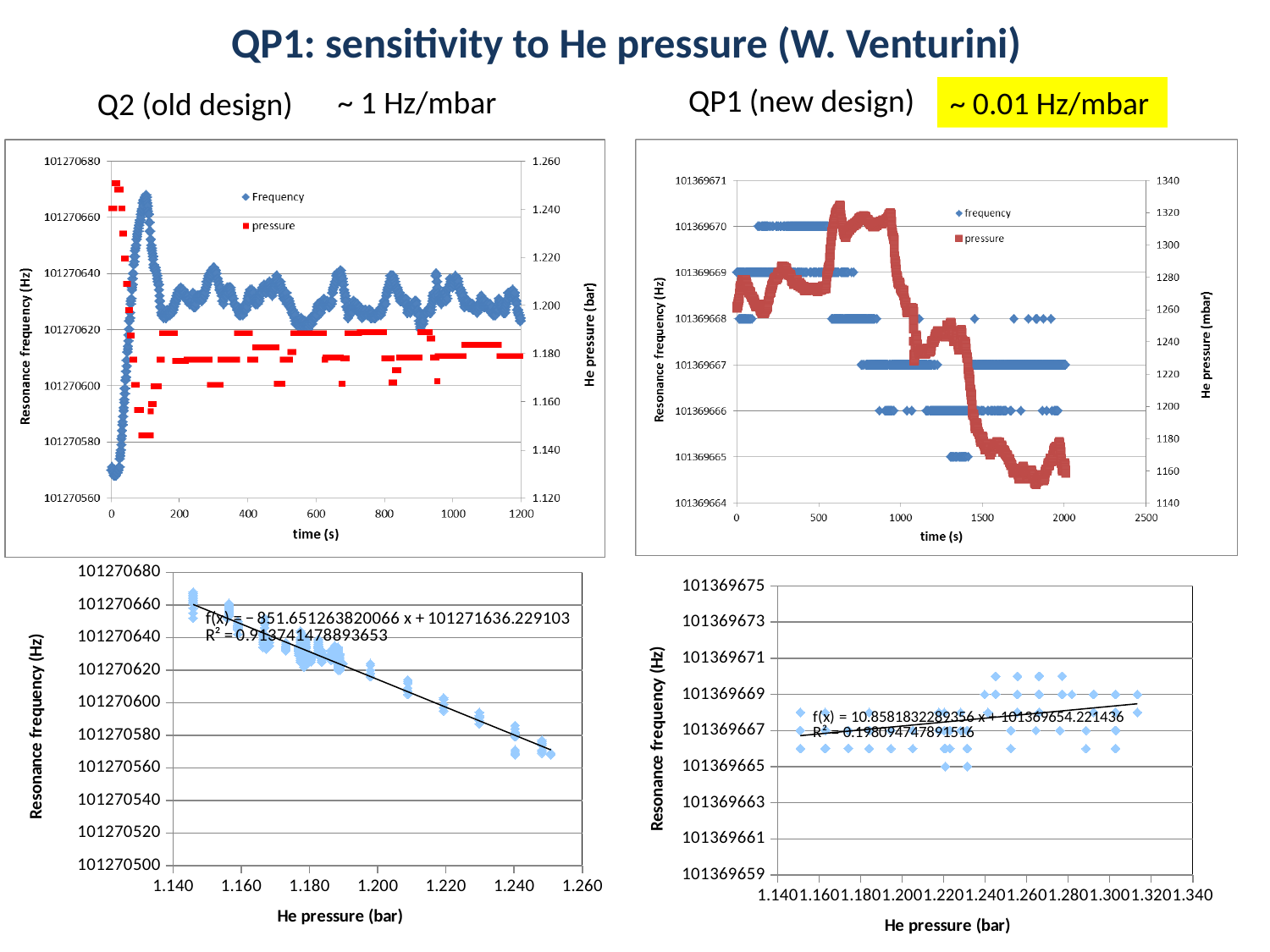
What kind of chart is the bottom-left chart (Resonance frequency vs He pressure for Q2)? scatter plot How many series does the legend of the top-left chart (Q2 old design, time series) list? 2 In the bottom-left chart, what is the slope of the fitted line f(x)? −851.651263820066 In the bottom-left chart, is the resonance frequency at a He pressure of 1.240 bar greater or less than 101270600? less In the top-right chart, is the He pressure at around 600 s greater or less than 1300 mbar? greater In the bottom-left chart, what is the R² value printed for the fitted line? 0.913741478893653 In the bottom-right chart, what is the slope of the fitted line f(x)? 10.8581832289356 In the bottom-left chart, does the resonance frequency rise or fall as He pressure increases? fall What is the x-axis label of the bottom-right chart? He pressure (bar) In the bottom-right chart, what is the R² value printed for the fitted line? 0.198094747891516 In the top-right chart, is the He pressure at around 1800 s greater or less than 1180 mbar? less What are the two legend entries in the top-right chart (QP1 new design, time series)? frequency, pressure